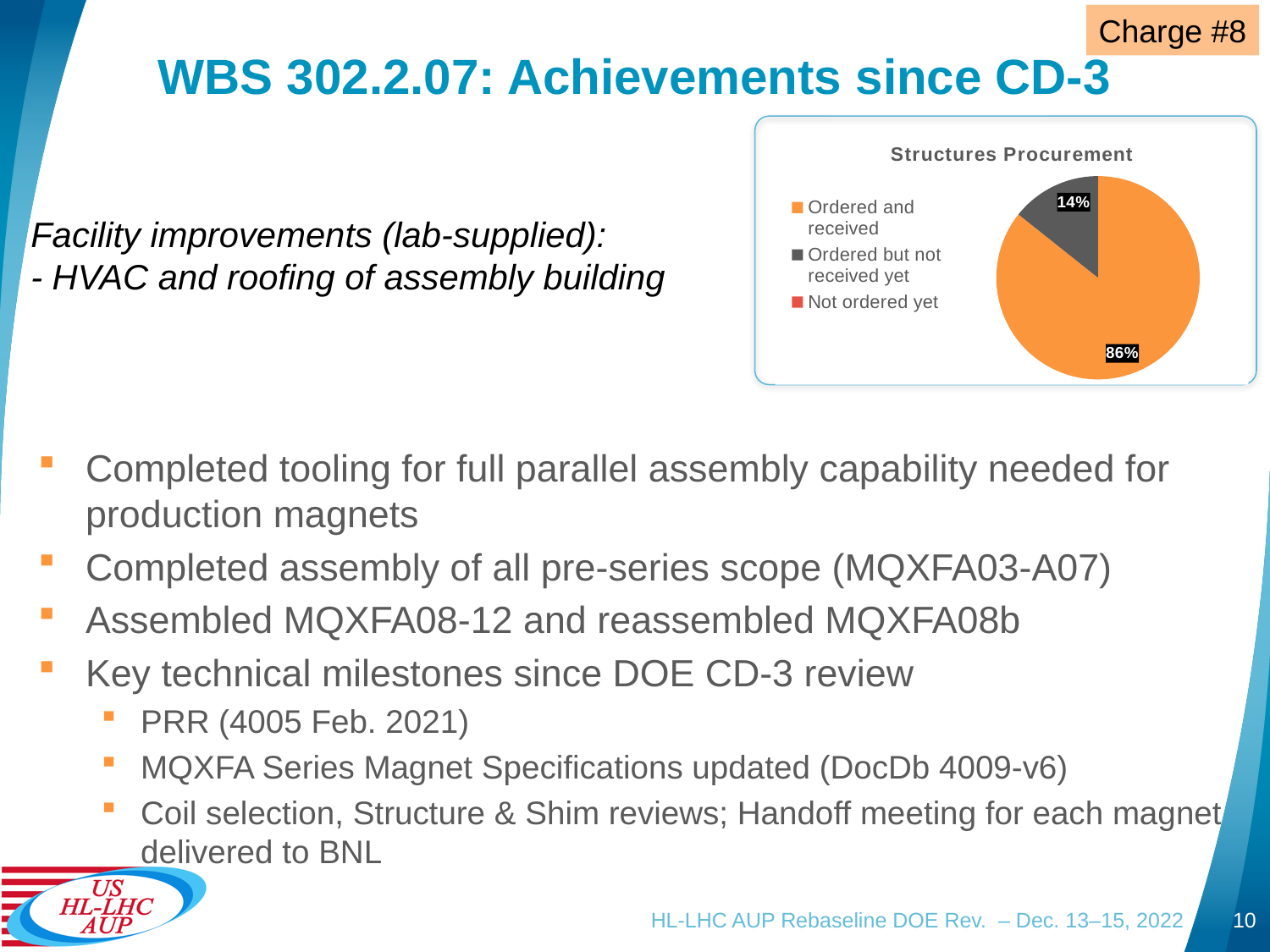
What share of the pie is labelled for 'Ordered but not received yet'? 14% What is the title of the chart? Structures Procurement Which category has the largest slice of the pie? Ordered and received How many slices of the pie have a percentage label printed on them? 2 Which legend entry is shown in orange? Ordered and received Is the share for 'Ordered and received' greater or less than 50%? greater What is the difference in percentage points between the 'Ordered and received' slice and the 'Ordered but not received yet' slice? 72 percentage points What kind of chart is shown on the slide? pie chart How many entries does the legend list? 3 What share of the pie is labelled for 'Ordered and received'? 86% Which of the two labelled slices is smaller, 'Ordered and received' or 'Ordered but not received yet'? Ordered but not received yet